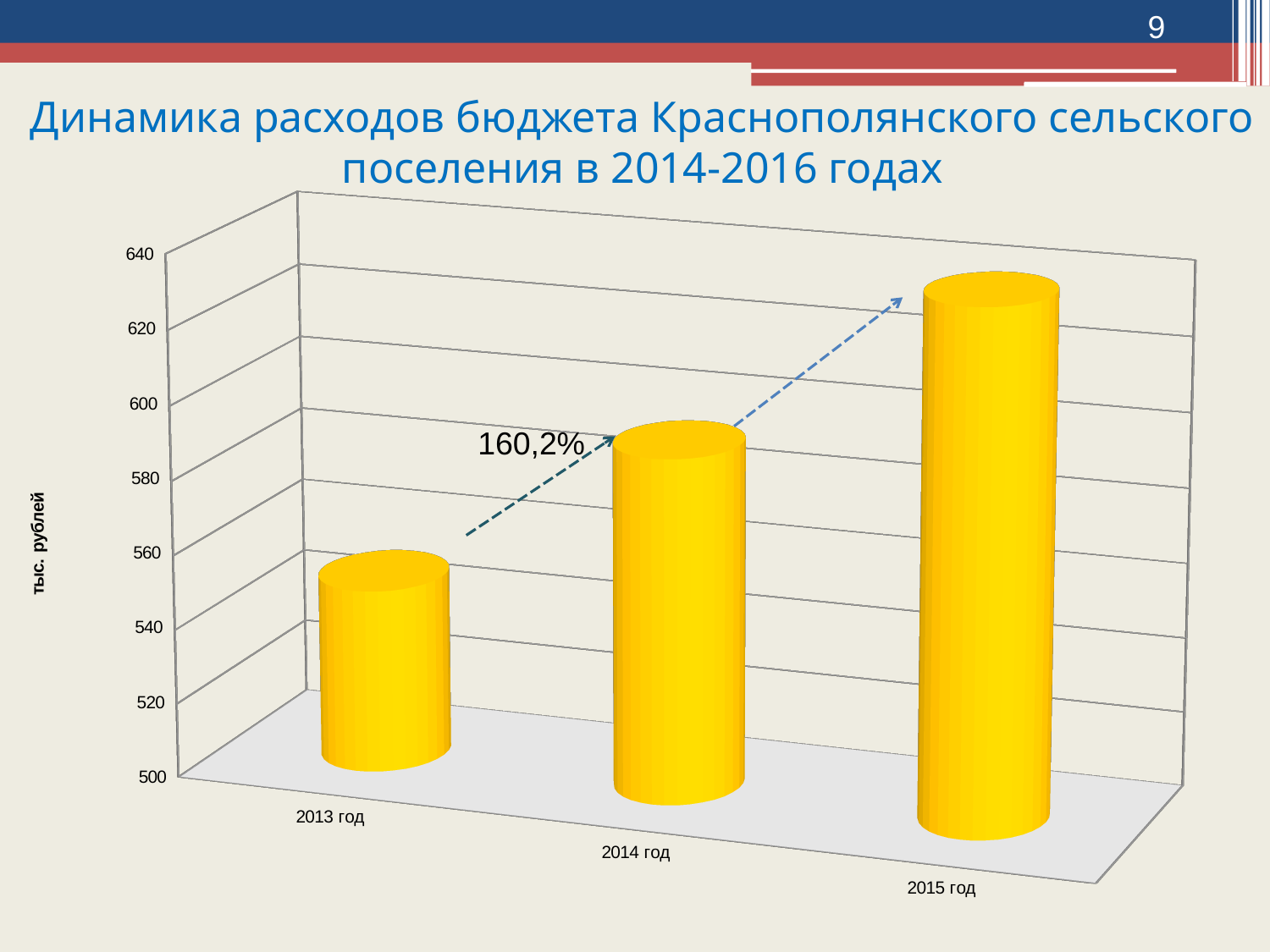
What kind of chart is shown on the slide? bar chart Is the value for 2013 год greater or less than 580? less Is the value for 2014 год greater or less than 560? greater How many categories (years) are plotted on the chart? 3 Do the values rise or fall from 2013 год to 2015 год? rise Which year has the highest value on the chart? 2015 год Which is larger, the value for 2014 год or the value for 2013 год? 2014 год What is the label on the vertical axis of the chart? тыс. рублей Is the value for 2014 год greater or less than 620? less What percentage is written next to the dashed arrow on the chart? 160,2% Which year has the lowest value on the chart? 2013 год